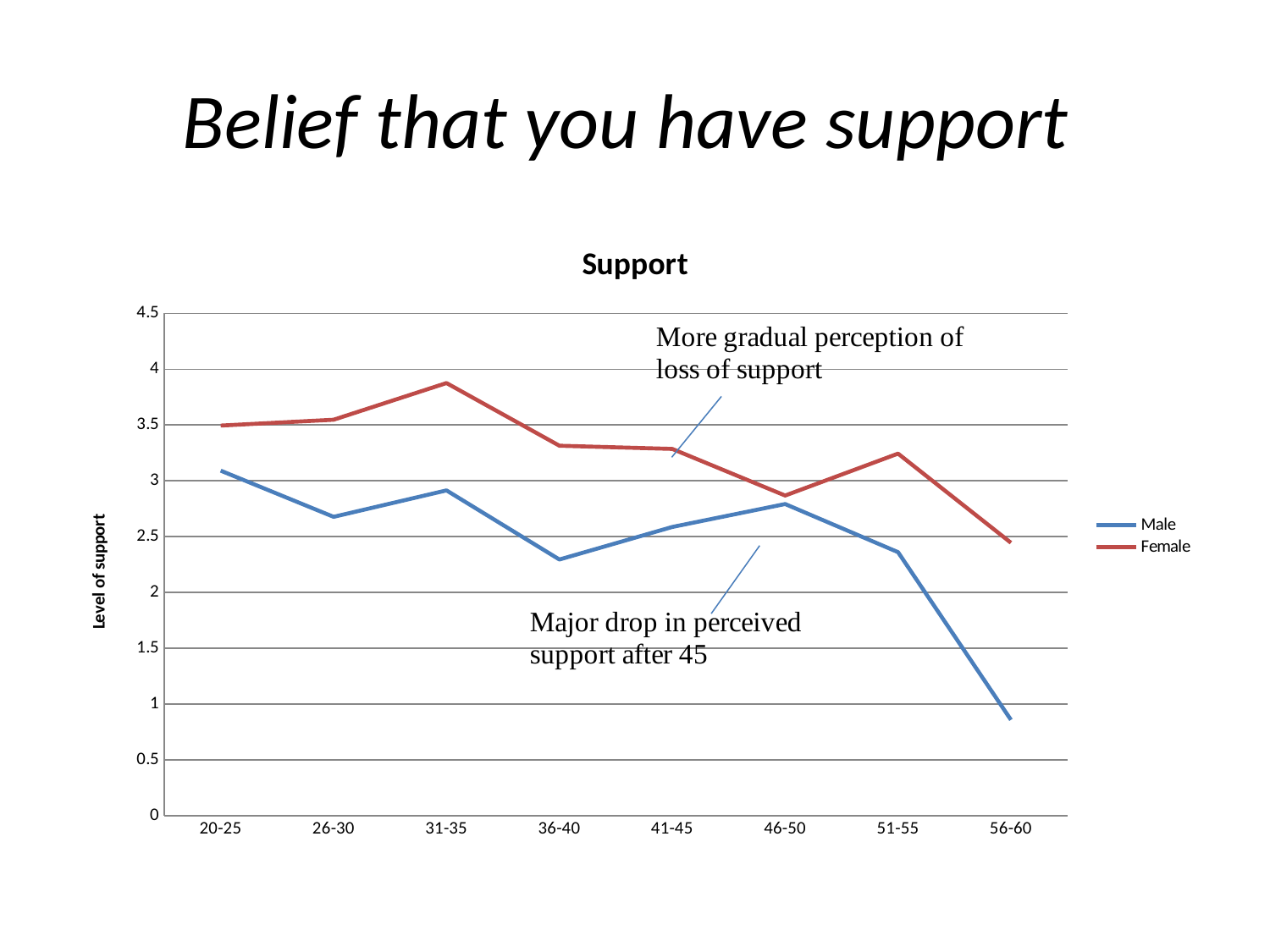
Is the value for Male at 56-60 greater or less than 1? less In which age group does the Male series reach its lowest value? 56-60 At age group 20-25, which series has the higher value, Male or Female? Female Does the Male series generally rise or fall from 20-25 to 56-60? fall How many age groups are shown on the x axis? 8 In which age group does the Female series reach its highest value? 31-35 What is the label on the vertical axis? Level of support What kind of chart is shown on the slide? line chart Is the value for Male at 36-40 greater or less than 2.5? less How many series does the legend list? 2 Is the value for Female at 31-35 greater or less than 3.5? greater What is the title of the chart? Support